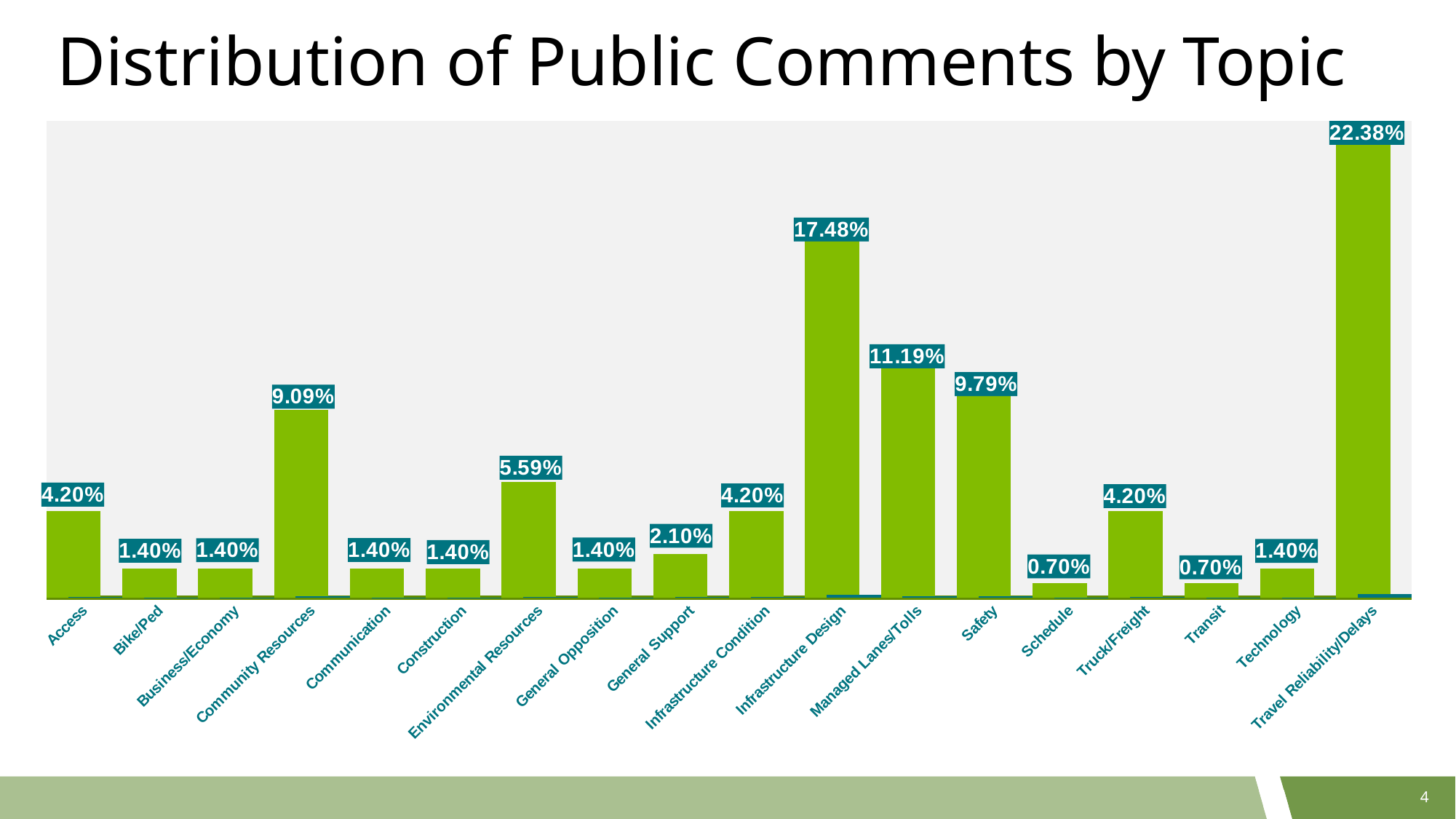
What percentage of public comments is about Travel Reliability/Delays? 22.38% What is the difference between the values for Travel Reliability/Delays and Infrastructure Design? 4.90% What percentage is shown for Managed Lanes/Tolls? 11.19% What is the title of the slide? Distribution of Public Comments by Topic What percentage of comments is about Schedule? 0.70% Which is larger, the value for Safety or the value for Managed Lanes/Tolls? Managed Lanes/Tolls How many topic categories are shown on the x axis? 18 What kind of chart is shown on the slide? Bar chart What is the value for Environmental Resources? 5.59% What is the difference between the values for Community Resources and Environmental Resources? 3.50% What is the value shown for Infrastructure Design? 17.48% Which topic has the highest share of public comments? Travel Reliability/Delays